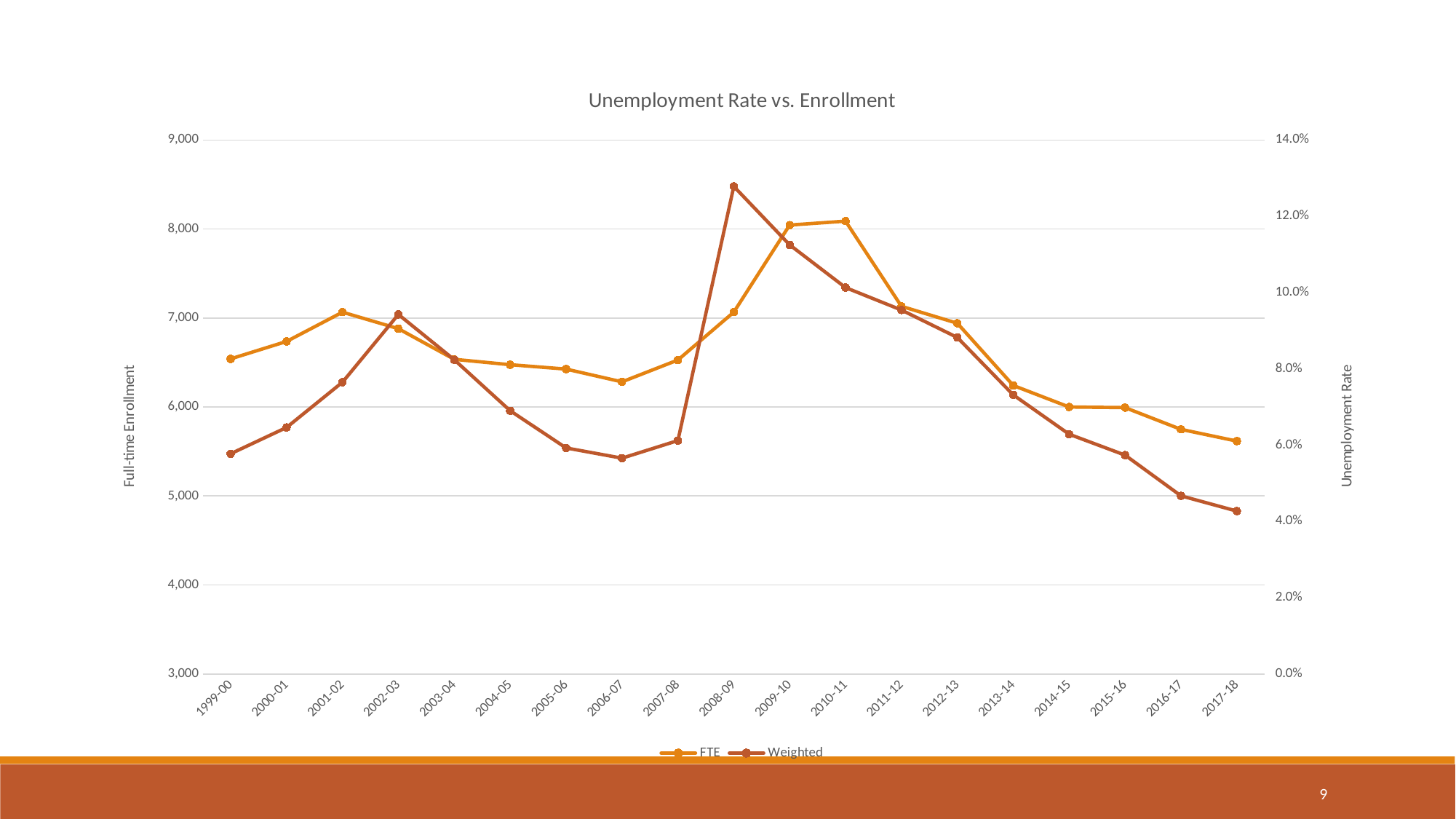
Is the Weighted unemployment rate for 2008-09 greater or less than 12.0%? greater What kind of chart is shown on the slide? line chart Is the Weighted unemployment rate for 2017-18 greater or less than 6.0%? less In which year is the Weighted unemployment rate at its lowest? 2017-18 How many series does the legend list? 2 Does the FTE series rise or fall from 2010-11 to 2017-18? fall What is the title of the chart? Unemployment Rate vs. Enrollment How many academic years are plotted along the x axis? 19 Is the FTE value for 2017-18 greater or less than 6,000? less In which year does the FTE series reach its highest value? 2010-11 In which year does the Weighted unemployment rate reach its highest value? 2008-09